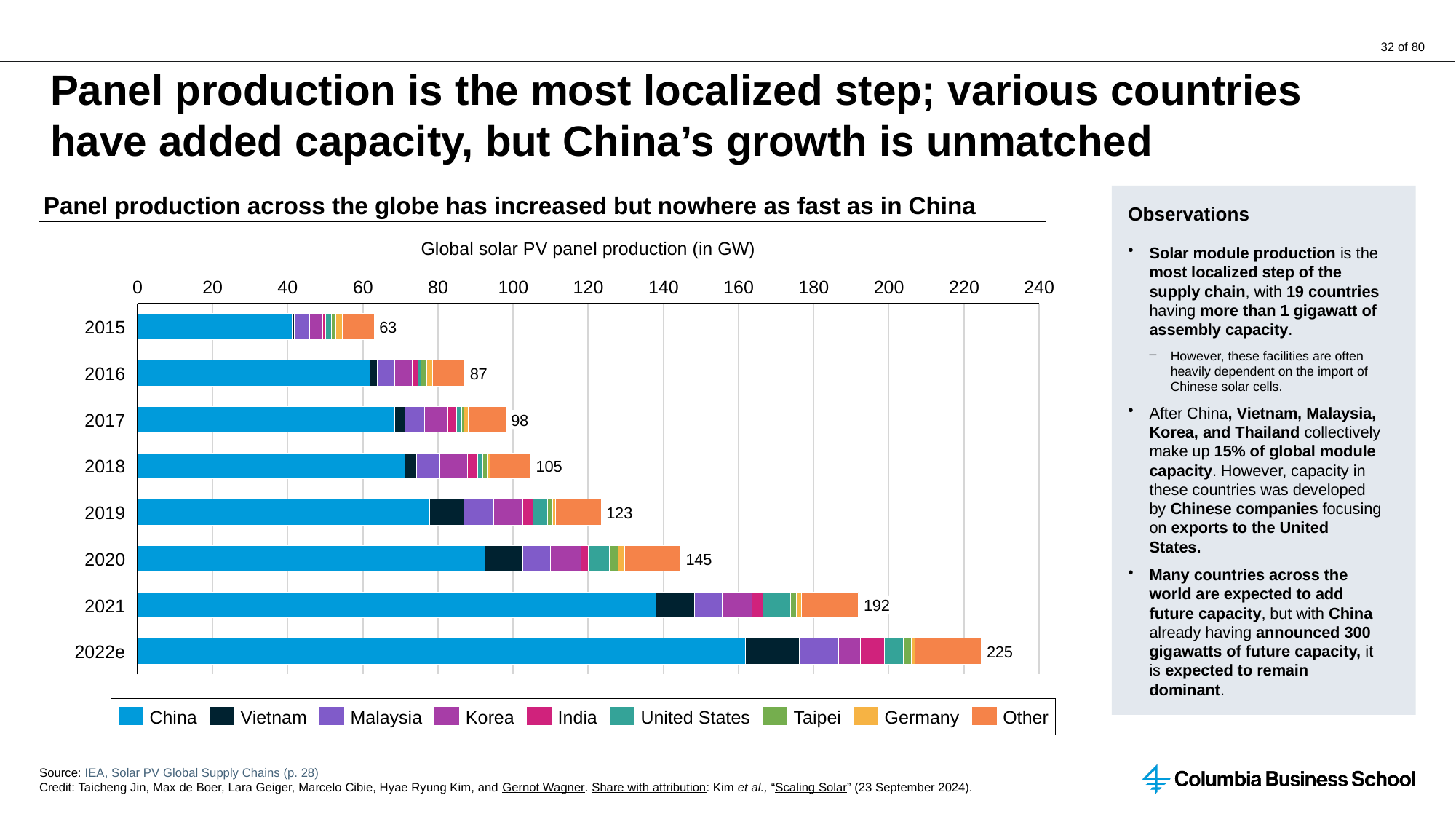
How many years are shown on the chart? 8 Do the total panel production values rise or fall from 2015 to 2022e? rise What is the total global solar PV panel production shown for 2015? 63 What is the difference between the total panel production in 2021 and in 2020? 47 Which year has a larger total panel production, 2017 or 2018? 2018 What is the difference between the total panel production in 2022e and in 2015? 162 Is China's panel production in 2022e greater or less than 140 GW? greater Which year has the lowest total panel production? 2015 How many series does the legend list? 9 What is the total global solar PV panel production shown for 2019? 123 Which year has the highest total panel production? 2022e What is the total global solar PV panel production shown for 2022e? 225